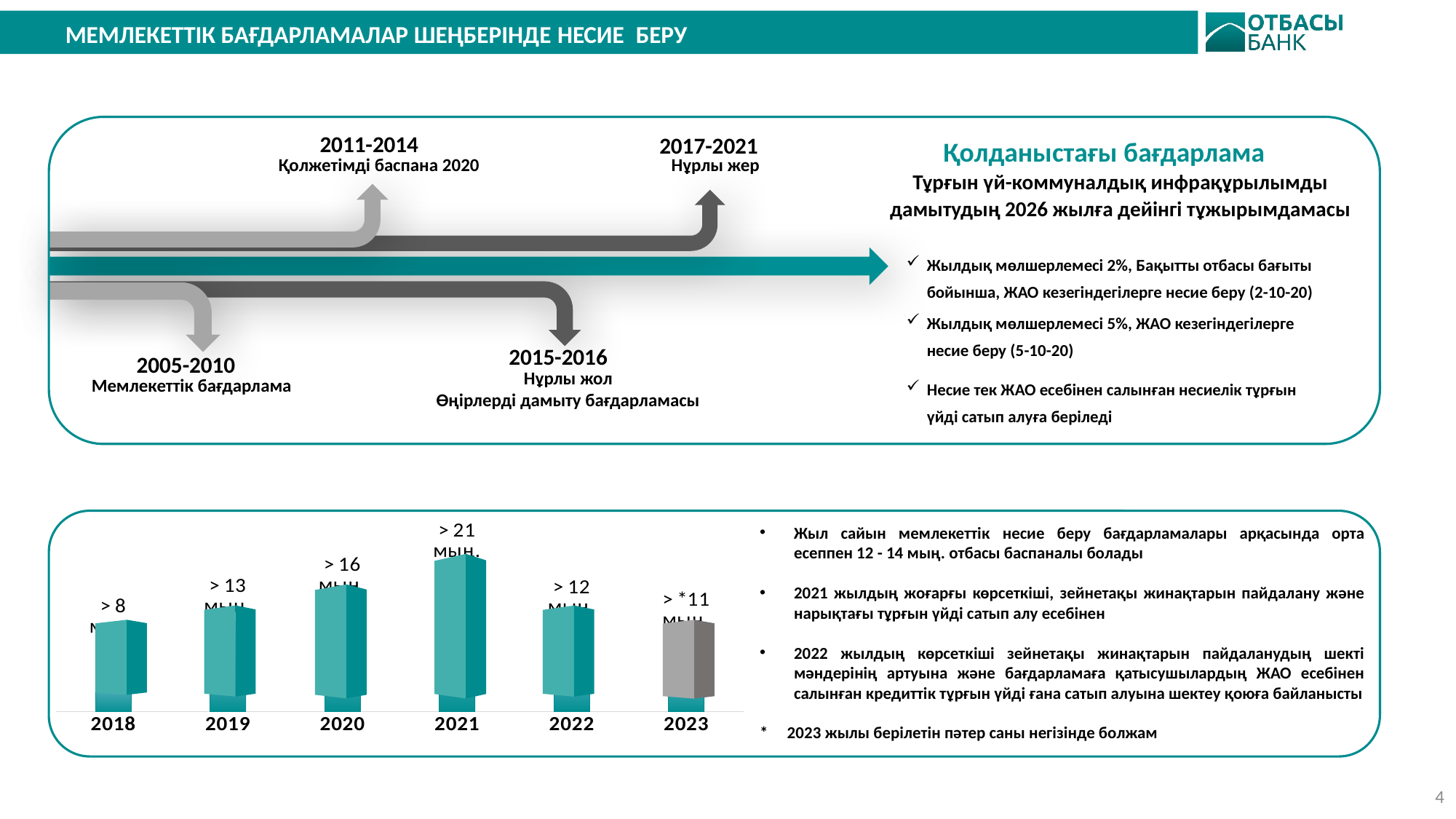
Which bar on the chart is coloured grey instead of teal? 2023 Which year has the highest bar on the chart? 2021 Which year has the lowest bar on the chart? 2018 Which year has the larger value on the bar chart, 2019 or 2022? 2019 How many years (categories) are shown on the bar chart? 6 Do the values on the bar chart rise or fall from 2018 to 2021? rise What is the data label shown for 2021 on the bar chart? > 21 мың What is the data label shown for 2023 on the bar chart? > *11 мың What kind of chart is shown at the bottom of the slide? bar chart Do the values on the bar chart rise or fall from 2021 to 2023? fall What is the data label shown for 2018 on the bar chart? > 8 мың What is the data label shown for 2020 on the bar chart? > 16 мың